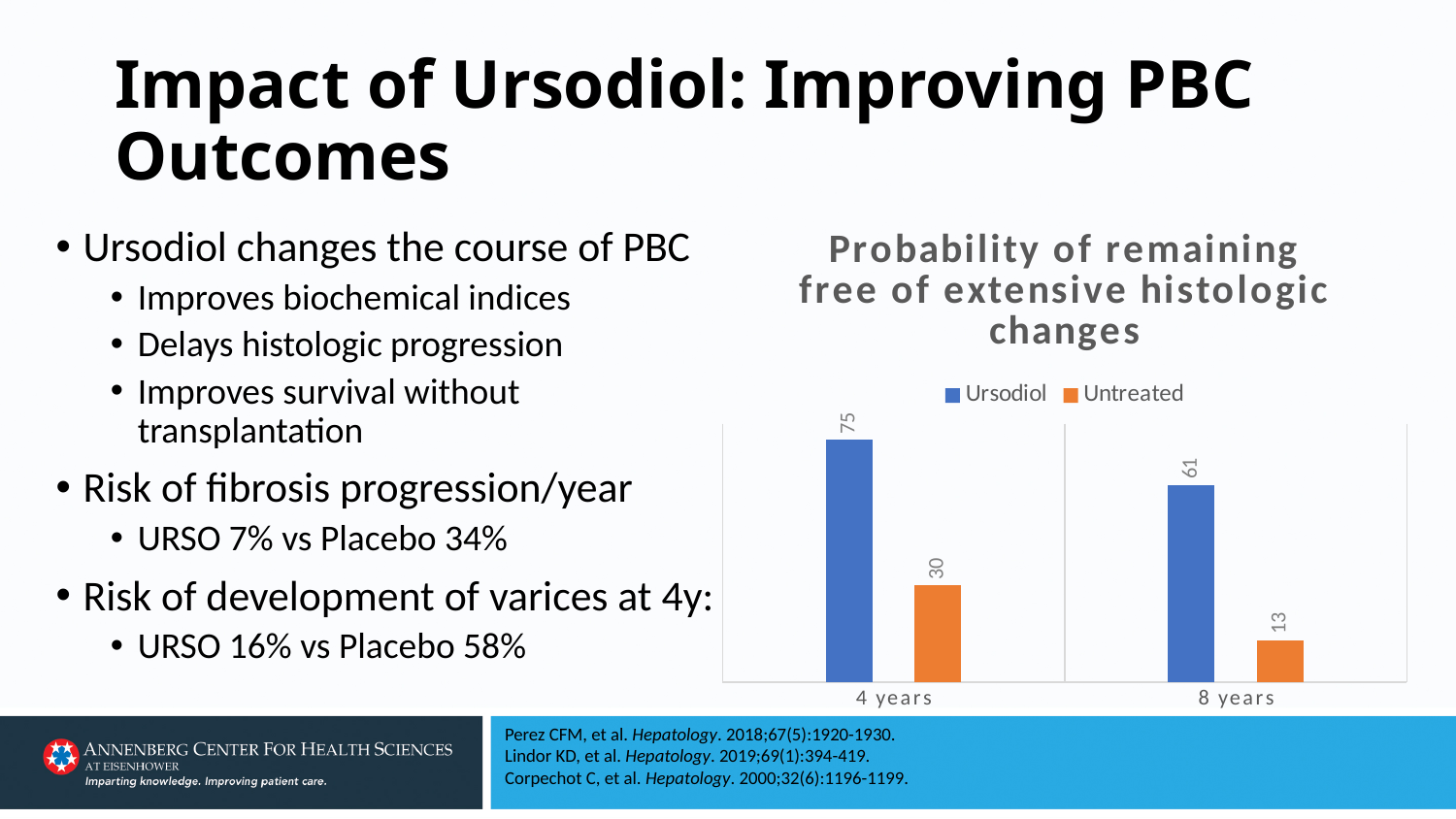
What is the title of the chart? Probability of remaining free of extensive histologic changes How many categories are shown on the x axis? 2 Which series has the highest value at 4 years? Ursodiol What kind of chart is shown on the slide? Bar chart How many series does the legend list? 2 What is the difference between the Ursodiol and Untreated values at 8 years? 48 Which is larger: the Untreated value at 4 years or the Untreated value at 8 years? Untreated at 4 years What is the value for Untreated at 8 years? 13 What is the value for Untreated at 4 years? 30 Which bar has the lowest value in the chart? Untreated at 8 years What is the value for Ursodiol at 8 years? 61 What is the value for Ursodiol at 4 years? 75